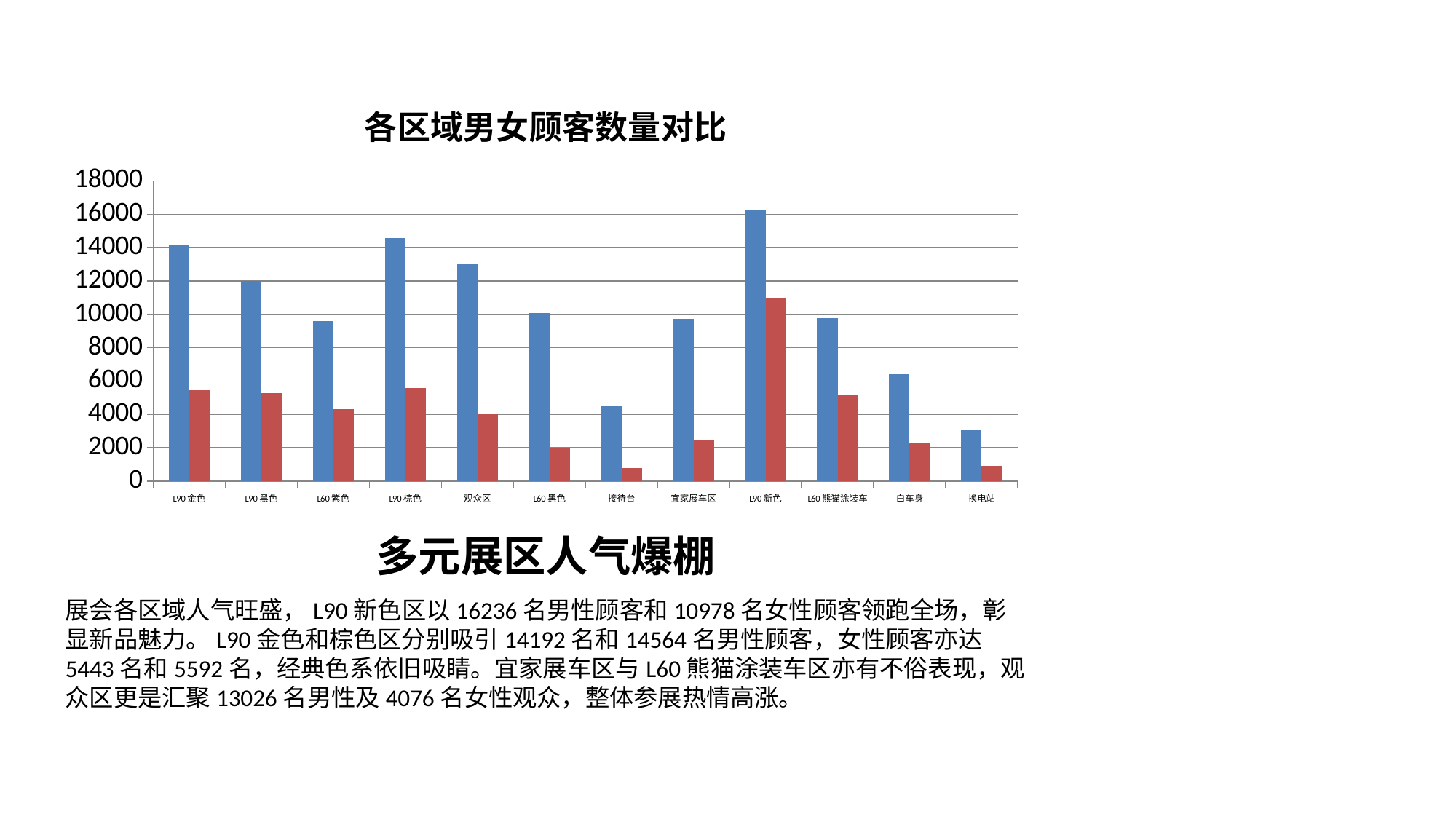
Is the red bar for L90 新色 greater or less than 10000? greater Which category has the tallest blue bar? L90 新色 What kind of chart is shown on the slide? bar chart Is the blue bar for 白车身 greater or less than 6000? greater Is the blue bar for L60 紫色 greater or less than 10000? less According to the slide text, how many male customers did the L90 新色 area attract? 16236 What is the title of the chart? 各区域男女顾客数量对比 Which category has the shortest blue bar? 换电站 Which category has the shortest red bar? 接待台 How many categories are shown on the x axis of the chart? 12 How many series (bar colours) are plotted in the chart? 2 Which has the taller blue bar, L90 新色 or 观众区? L90 新色